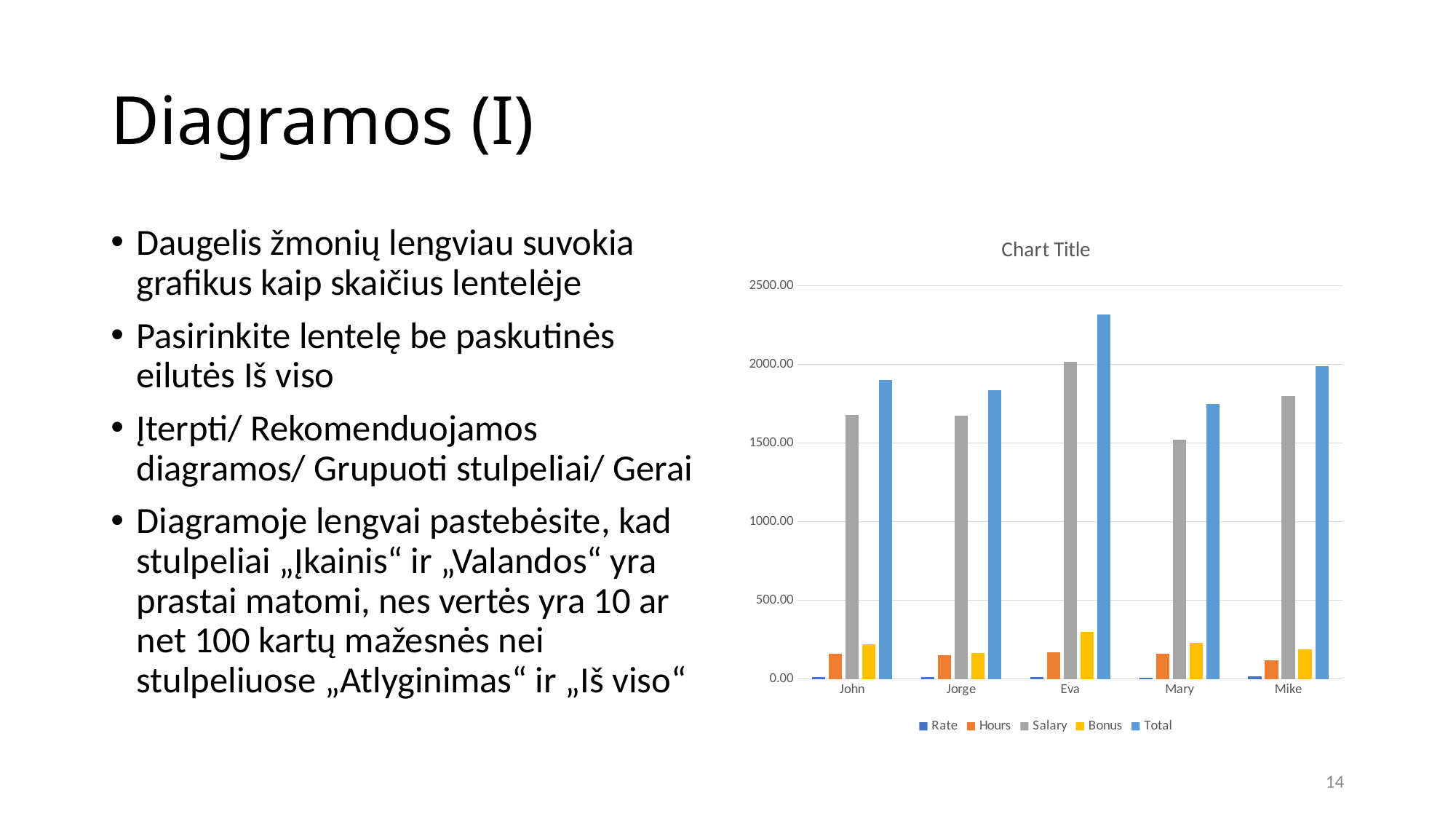
Is the Total value for Jorge greater or less than 2000.00? less Which is larger, the Total value for Eva or the Total value for Mike? Eva Which person has the highest Total value? Eva Is the Total value for Eva greater or less than 2000.00? greater Which person has the lowest Total value? Mary Which person has the highest Salary value? Eva What kind of chart is shown on the slide? bar chart How many categories (people) are shown on the x axis of the chart? 5 How many series does the chart legend list? 5 What is the title shown above the chart? Chart Title Is the Total value for Mary greater or less than 1500.00? greater Which person has the lowest Salary value? Mary